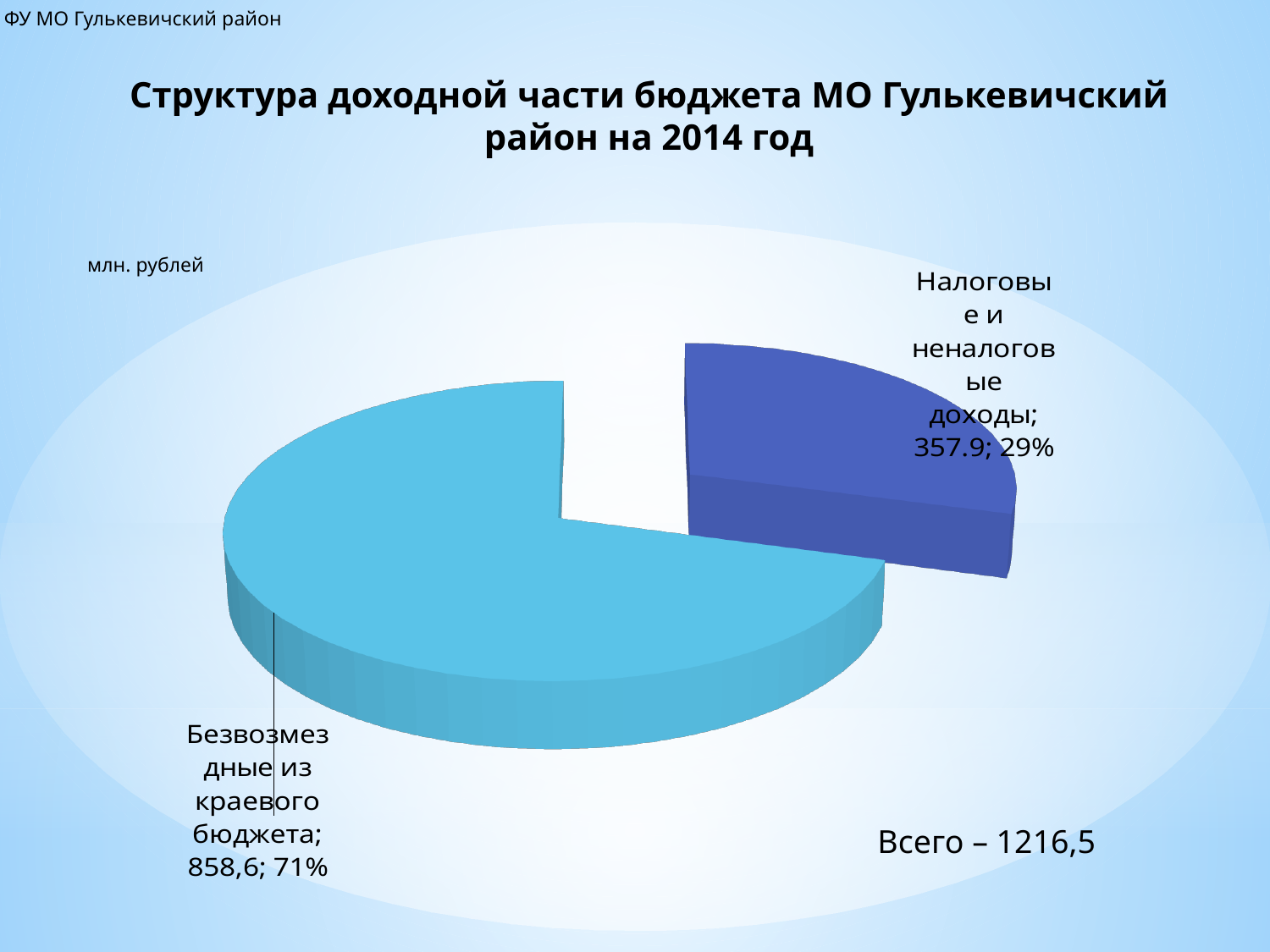
What share of the pie does Налоговые и неналоговые доходы represent? 29% By how many percentage points does the share of Безвозмездные из краевого бюджета exceed the share of Налоговые и неналоговые доходы? 42 percentage points What type of chart is shown on the slide? pie chart How many slices does the pie chart have? 2 Which category has the smallest slice of the pie? Налоговые и неналоговые доходы In what units are the values on the chart given? млн. рублей What is the value for Налоговые и неналоговые доходы? 357.9 What share of the pie does Безвозмездные из краевого бюджета represent? 71% What total (Всего) is stated on the slide for the budget revenue? 1216,5 Which is larger: Налоговые и неналоговые доходы or Безвозмездные из краевого бюджета? Безвозмездные из краевого бюджета Which category has the largest slice of the pie? Безвозмездные из краевого бюджета What is the value for Безвозмездные из краевого бюджета? 858,6